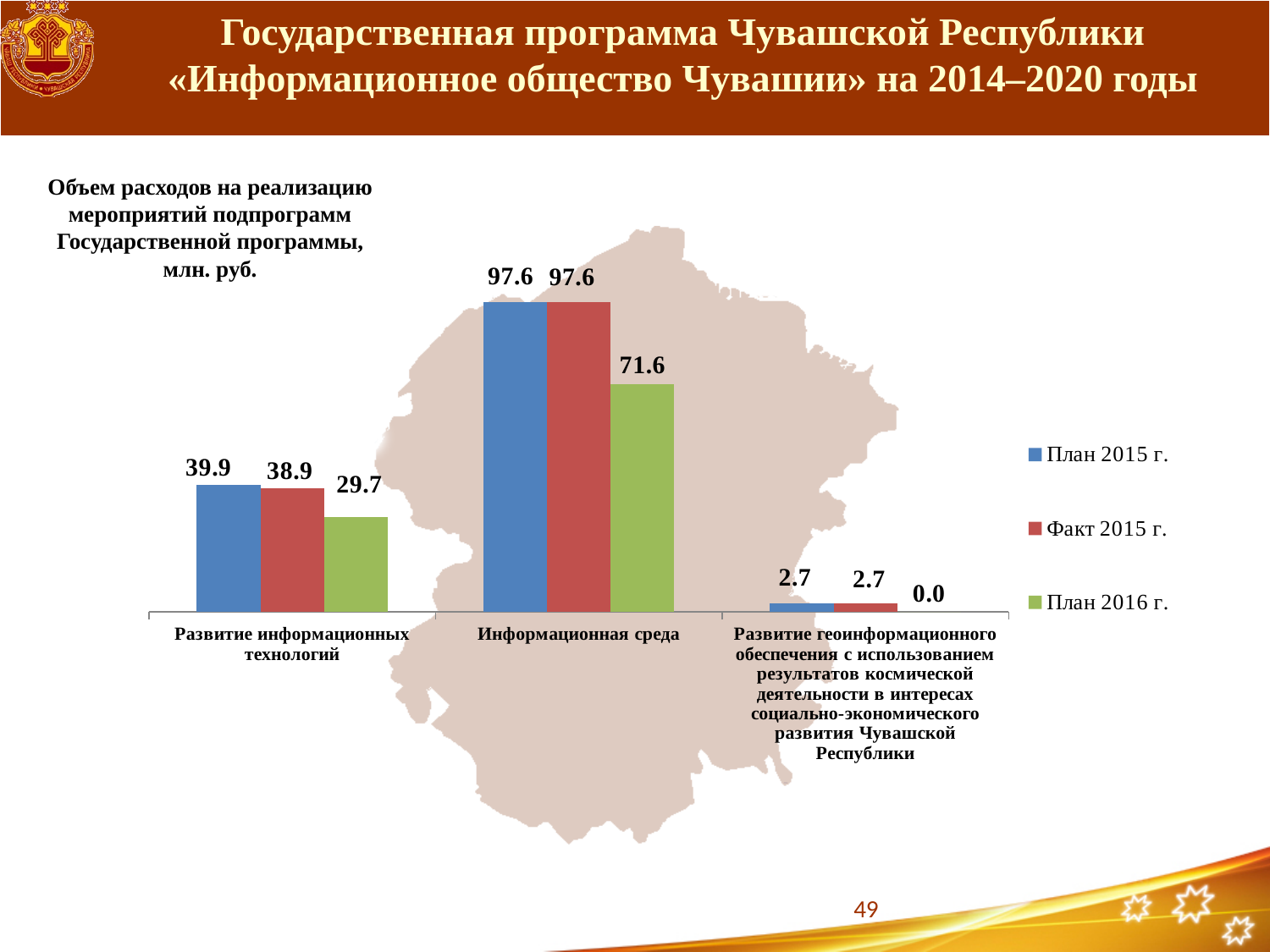
What is the value of Факт 2015 г. for Развитие информационных технологий? 38.9 What is the difference between План 2015 г. and Факт 2015 г. for Развитие информационных технологий? 1.0 What is the value of План 2015 г. for Развитие информационных технологий? 39.9 What is the value of План 2016 г. for Развитие геоинформационного обеспечения с использованием результатов космической деятельности в интересах социально-экономического развития Чувашской Республики? 0.0 Which is larger for Развитие информационных технологий: Факт 2015 г. or План 2016 г.? Факт 2015 г. How many categories are shown on the x axis? 3 What is the difference between План 2015 г. and План 2016 г. for Информационная среда? 26.0 What kind of chart is shown on the slide? bar chart Which category has the highest value for План 2015 г.? Информационная среда How many series does the legend list? 3 What is the value of План 2016 г. for Информационная среда? 71.6 Which category has the lowest value for Факт 2015 г.? Развитие геоинформационного обеспечения с использованием результатов космической деятельности в интересах социально-экономического развития Чувашской Республики